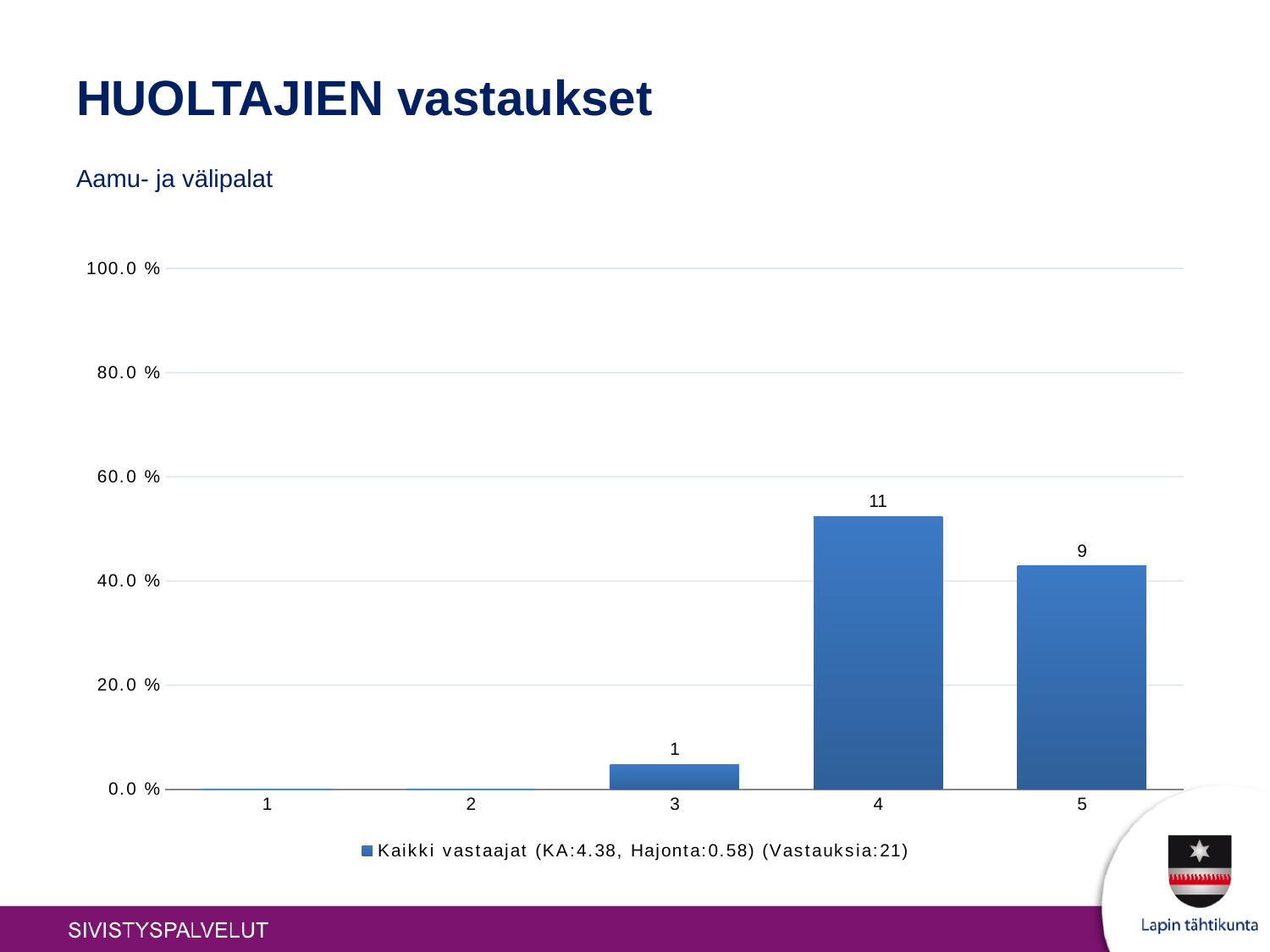
How many series does the legend list? 1 How many categories are shown on the x axis? 5 Is the value for category 5 greater or less than 60.0 %? less What is the data label on the bar for category 4? 11 What is the difference between the data labels for category 4 and category 5? 2 Which category has the highest bar? 4 What kind of chart is shown on the slide? bar chart Is the value for category 4 greater or less than 40.0 %? greater What is the data label on the bar for category 5? 9 Which has the larger value, category 3 or category 5? 5 What is the data label on the bar for category 3? 1 Is the value for category 3 greater or less than 20.0 %? less